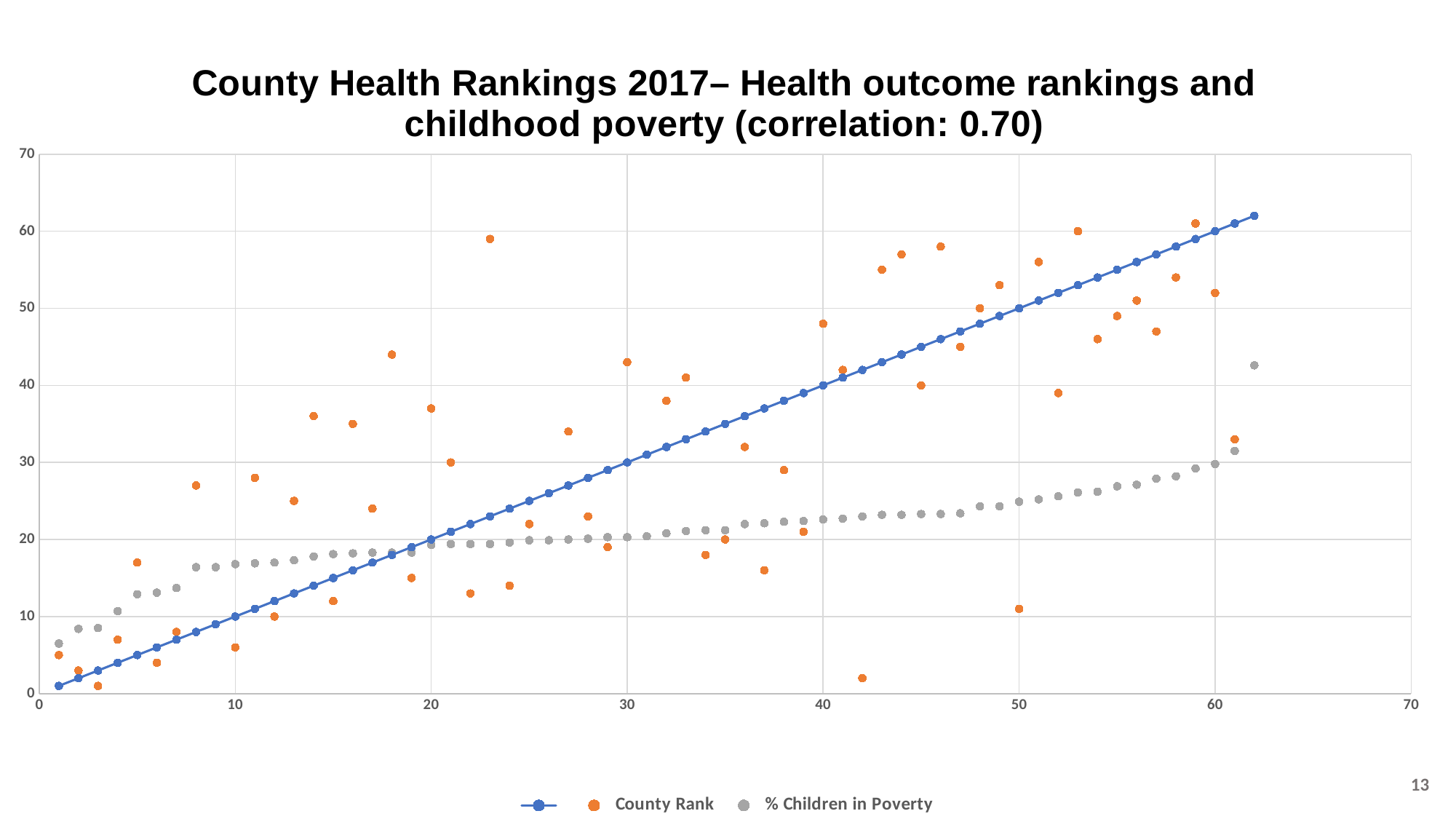
What is the highest value shown on the y axis? 70 Is the % Children in Poverty value at x = 1 greater or less than 10? less What is the title of the chart? County Health Rankings 2017– Health outcome rankings and childhood poverty (correlation: 0.70) Is the County Rank value at x = 23 greater or less than 50? greater What kind of chart is shown on the slide? scatter chart What correlation value is stated in the chart title? 0.70 Which is larger: the County Rank value at x = 23 or the County Rank value at x = 22? x = 23 Which is larger: the % Children in Poverty value at x = 62 or at x = 1? x = 62 Does the % Children in Poverty series generally rise or fall as the x value increases? rise Is the % Children in Poverty value at x = 62 greater or less than 40? greater